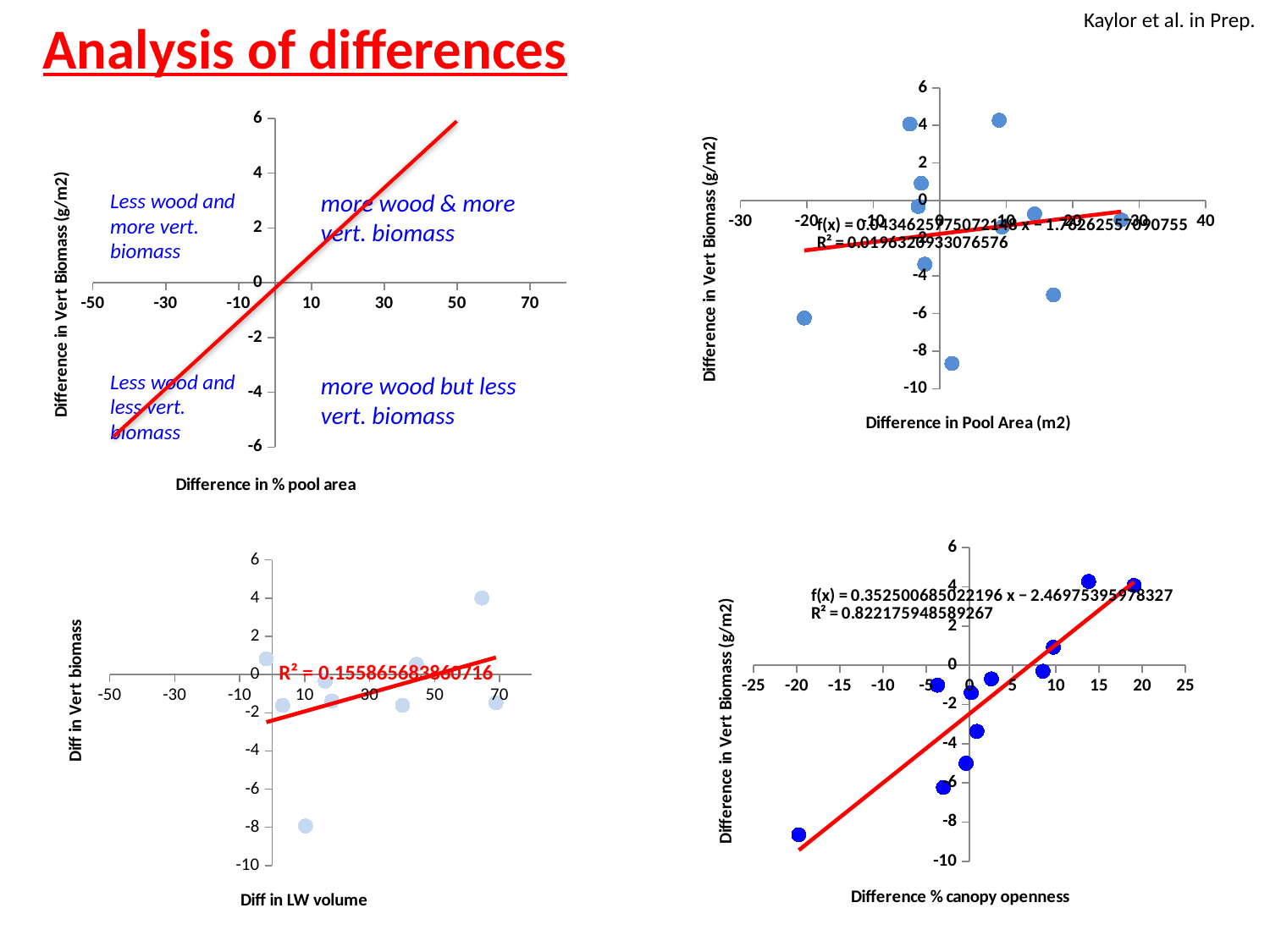
In the bottom-left chart (Diff in LW volume), what is the R² value shown? 0.155865683860716 Which of the three scatter charts shows the highest R² value? Difference % canopy openness In the top-right chart (Difference in Pool Area (m2)), is the x value of the leftmost point greater or less than -10? less Which chart has the larger R² value: the bottom-left chart (Diff in LW volume) or the bottom-right chart (Difference % canopy openness)? Difference % canopy openness In the top-right chart (Difference in Pool Area (m2)), what is the R² value shown? 0.0196320933076576 In the bottom-right chart (Difference % canopy openness), is the y value of the lowest point greater or less than -8? less In the bottom-right chart (Difference % canopy openness), what is the slope coefficient in the fitted equation f(x)? 0.352500685022196 In the bottom-right chart (Difference % canopy openness), what is the R² value shown? 0.822175948589267 What kind of chart is the bottom-right chart titled 'Difference % canopy openness'? scatter chart In the top-left quadrant diagram, what label is written in the upper-right quadrant? more wood & more vert. biomass In the bottom-left chart (Diff in LW volume), is the y value of the highest point greater or less than 2? greater In the bottom-right chart (Difference % canopy openness), do the points generally rise or fall as the x value increases? rise